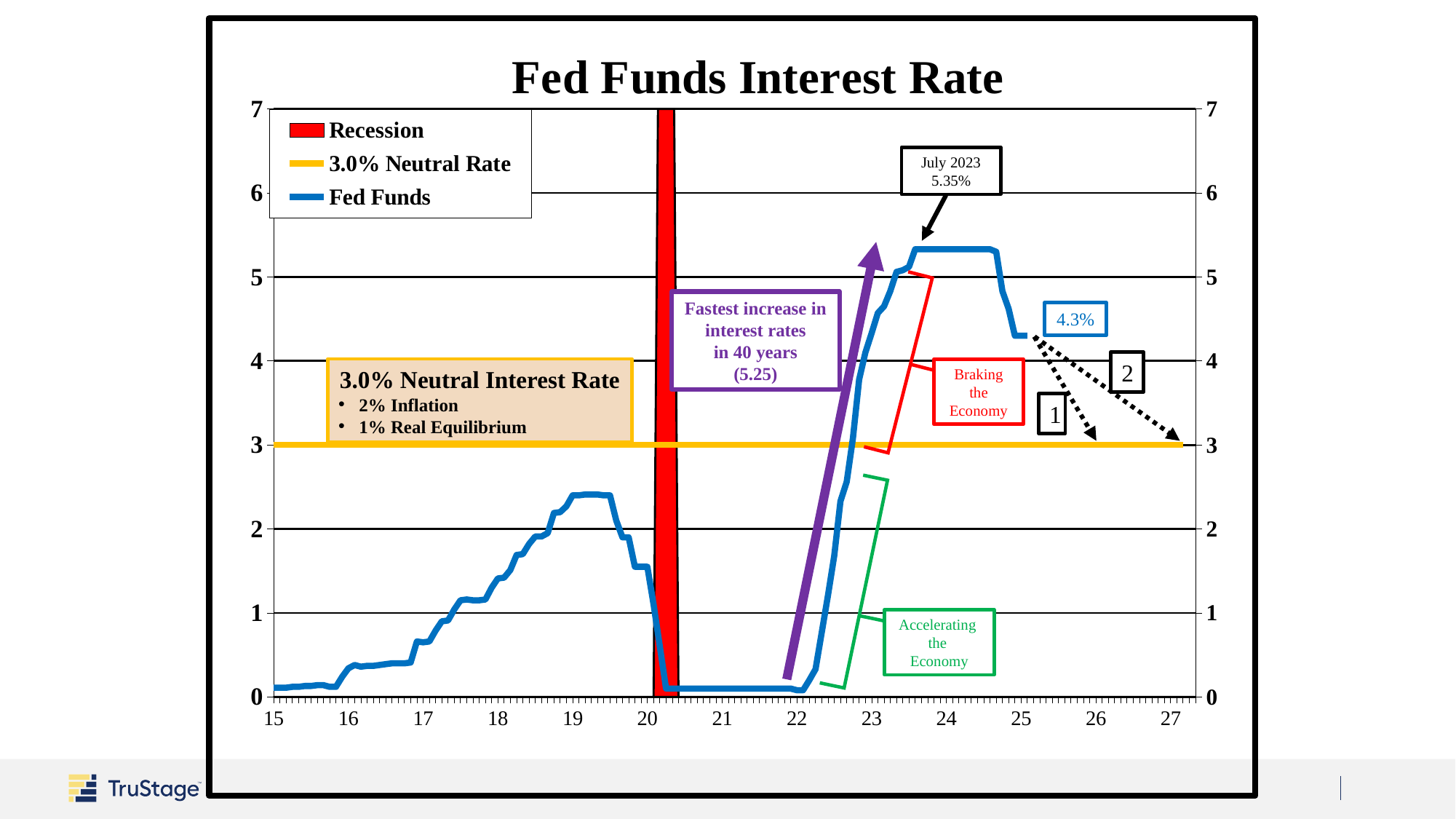
Is the Fed Funds rate during 2021 greater or less than 1? less Which is larger, the July 2023 rate or the 4.3% labeled rate? July 2023 rate (5.35%) What is the title of the chart? Fed Funds Interest Rate What is the difference between the July 2023 rate of 5.35% and the later labeled rate of 4.3%? 1.05% What is the neutral interest rate shown by the yellow horizontal line? 3.0% Is the Fed Funds rate at its 2019 peak greater or less than 3? less What Fed Funds rate is labeled for July 2023? 5.35% Does the Fed Funds line rise or fall between 22 and 23 on the x axis? rise What kind of chart is shown on the slide? line chart Is the Fed Funds rate at the start of 2024 greater or less than 5? greater How many entries does the chart's legend list? 3 What is the most recent Fed Funds rate value labeled on the chart, near year 25? 4.3%